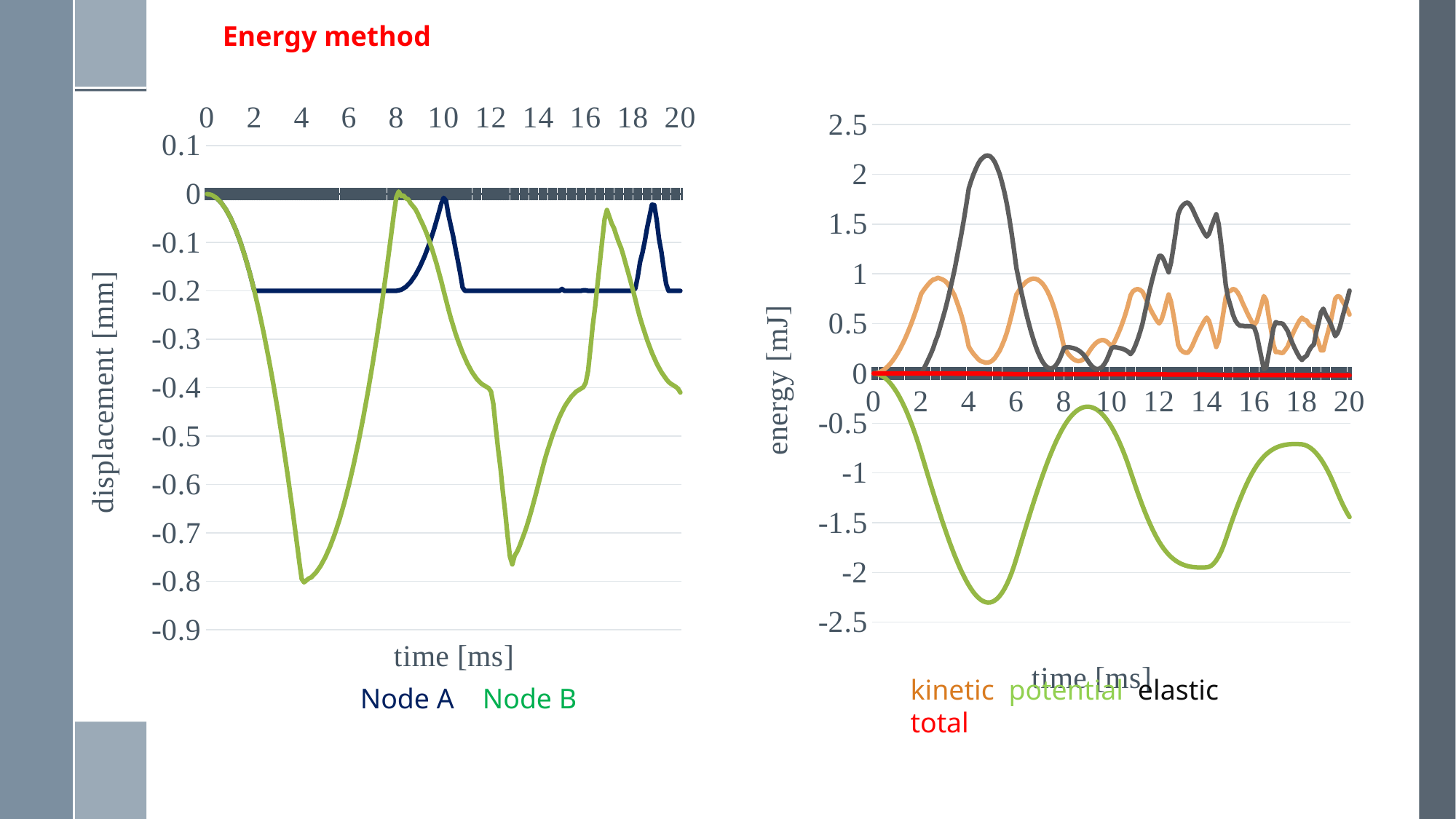
In the left chart (displacement vs time), which series reaches the lowest displacement value? Node B What is the y-axis label of the right chart? energy [mJ] In the right chart (energy vs time), is the peak value of the elastic series near 5 ms greater or less than 2? greater How many series does the legend of the right chart (energy vs time) list? 4 In the left chart (displacement vs time), is the value for Node B at 4 ms greater or less than -0.7? less In the right chart (energy vs time), is the lowest value of the potential series near 5 ms greater or less than -2? less What kind of chart is the left chart (displacement vs time)? line chart In the right chart (energy vs time), which series is larger at 5 ms, elastic or kinetic? elastic What is the y-axis label of the left chart? displacement [mm] How many series does the legend of the left chart (displacement vs time) list? 2 In the right chart (energy vs time), which series reaches the highest energy value? elastic